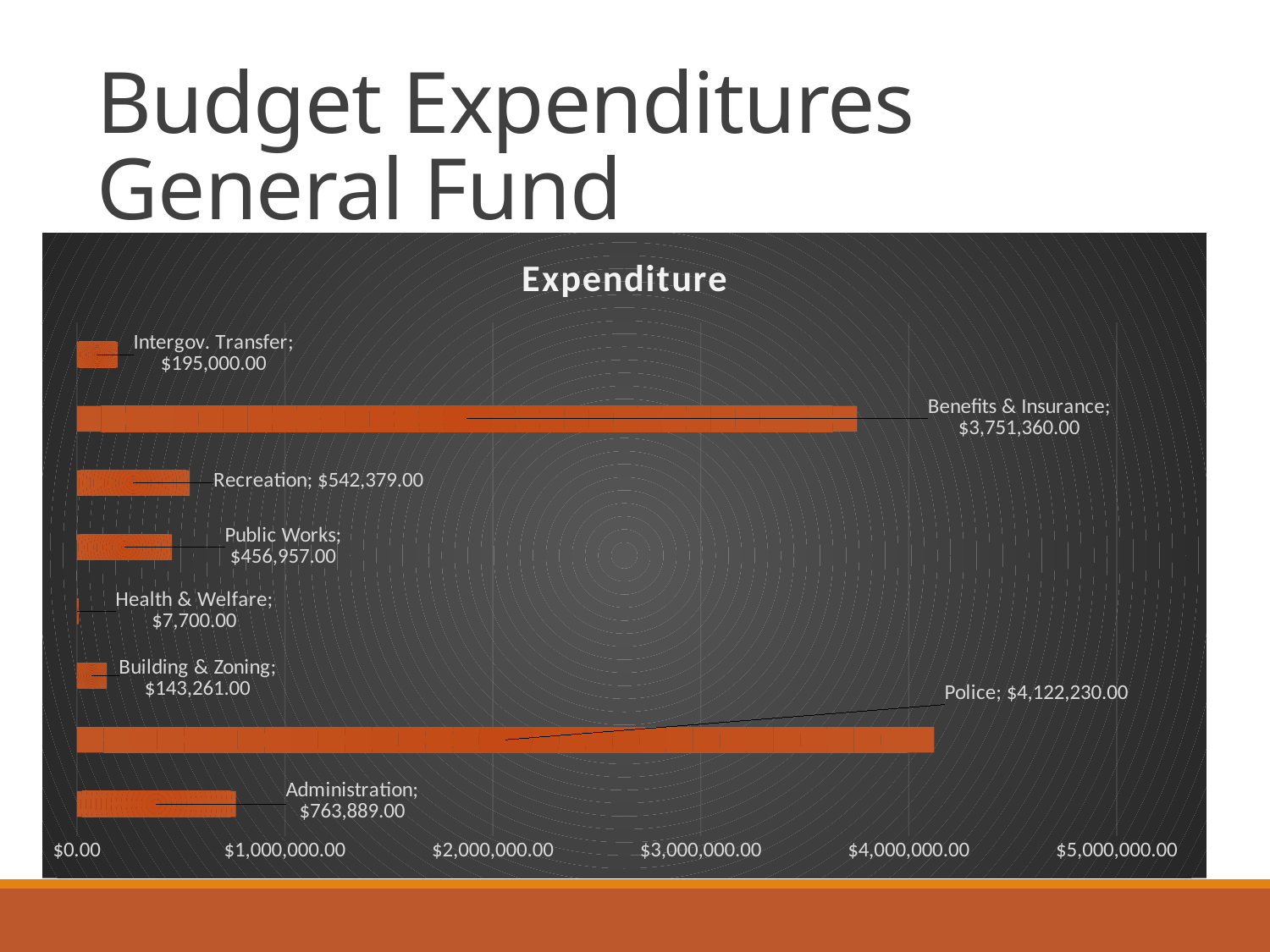
What is the value for Administration in the Expenditure chart? $763,889.00 What is the value for Police in the Expenditure chart? $4,122,230.00 How many categories are shown in the Expenditure chart? 8 What is the value for Health & Welfare in the Expenditure chart? $7,700.00 What is the difference between the Recreation and Public Works expenditures? $85,422.00 Is the value for Benefits & Insurance greater or less than $4,000,000.00? less What kind of chart is shown on the slide? Bar chart What is the difference between the Police and Benefits & Insurance expenditures? $370,870.00 What is the value for Benefits & Insurance in the Expenditure chart? $3,751,360.00 Which category has the lowest expenditure? Health & Welfare Which category has the highest expenditure? Police Which is larger, the expenditure for Recreation or for Public Works? Recreation